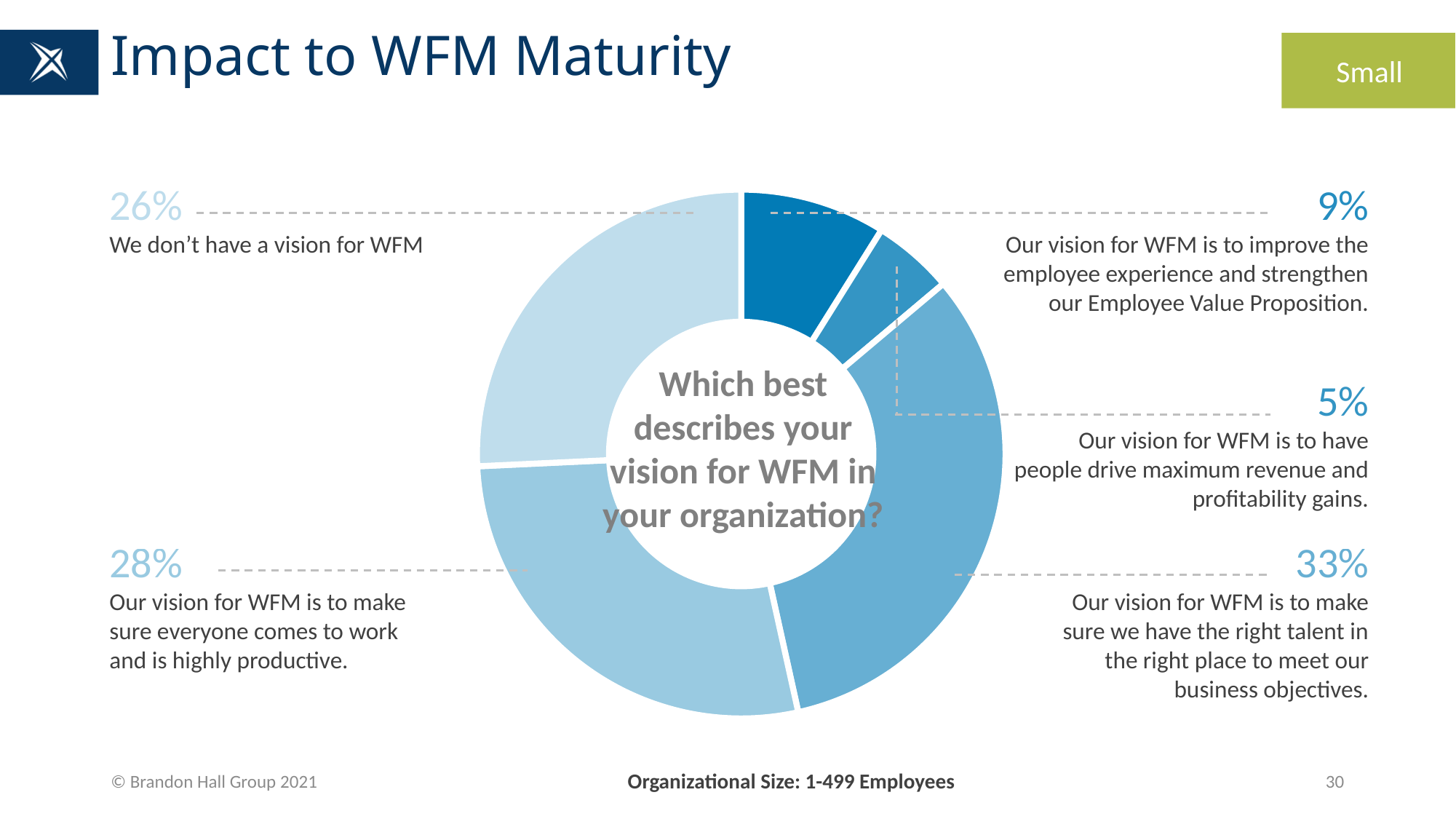
Which response has the largest share of the chart? Our vision for WFM is to make sure we have the right talent in the right place to meet our business objectives (33%) What is the difference in percentage points between the "right talent in the right place" response (33%) and the "everyone comes to work and is highly productive" response (28%)? 5 percentage points Which response has the smallest share of the chart? Our vision for WFM is to have people drive maximum revenue and profitability gains (5%) What percentage of respondents said "We don't have a vision for WFM"? 26% Which is larger: the share for "We don't have a vision for WFM" or the share for "make sure everyone comes to work and is highly productive"? make sure everyone comes to work and is highly productive (28%) How many categories (slices) does the chart show? 5 What organizational size does the chart's footer say the data covers? 1-499 Employees What kind of chart is shown on the slide? doughnut chart What percentage of respondents said their vision for WFM is to make sure everyone comes to work and is highly productive? 28% What percentage of respondents said their vision for WFM is to improve the employee experience and strengthen their Employee Value Proposition? 9% What percentage of respondents said their vision for WFM is to have people drive maximum revenue and profitability gains? 5% What question is written in the center of the donut chart? Which best describes your vision for WFM in your organization?